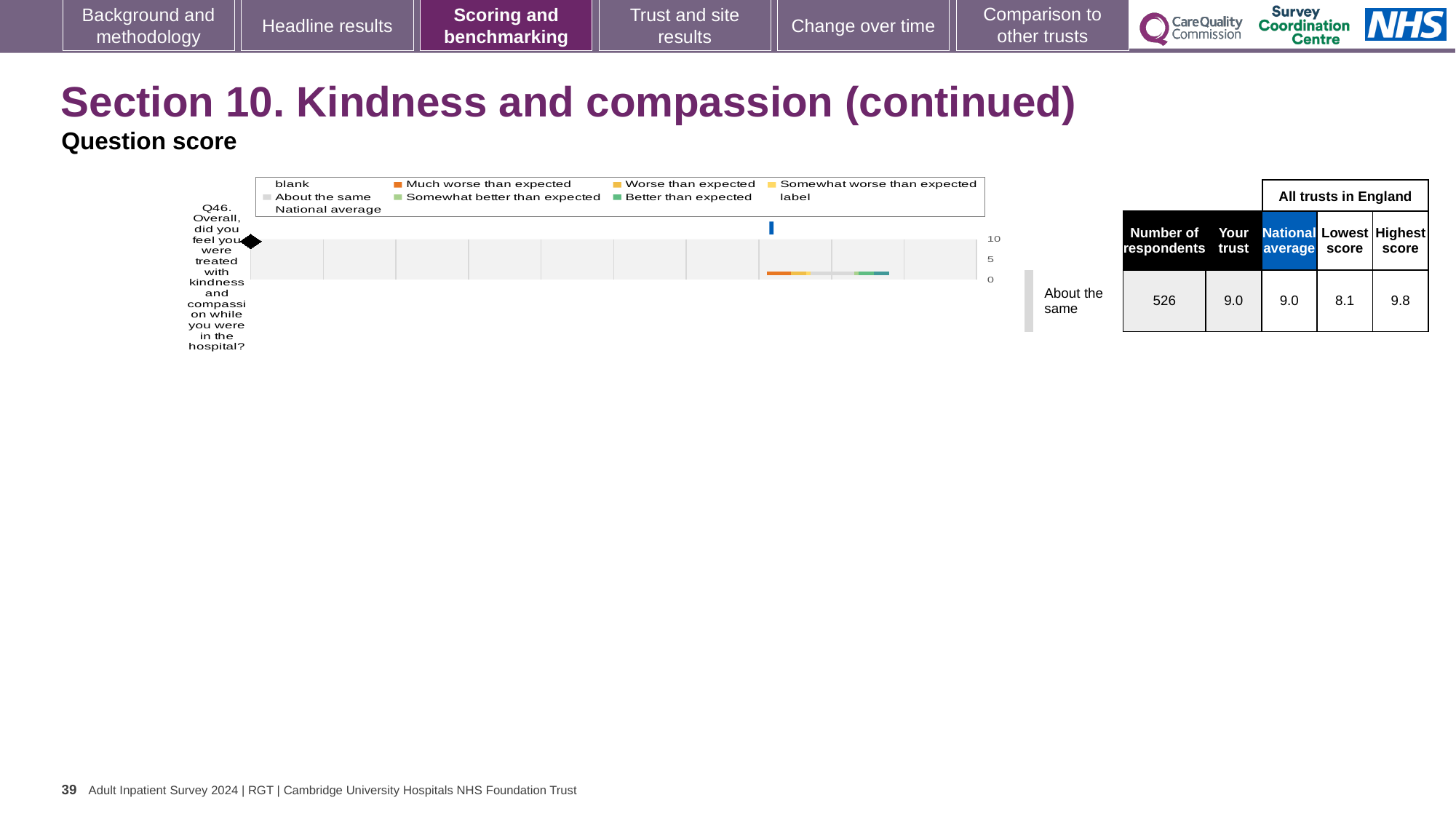
What kind of chart is shown on the slide for Q46? bar chart How many questions (categories) are plotted in the chart? 1 What is the difference between the highest score and the lowest score for Q46? 1.7 What is the 'Your trust' score for Q46 in the table beside the chart? 9.0 What is the highest score among all trusts in England for Q46? 9.8 What is the lowest score among all trusts in England for Q46? 8.1 How many entries does the chart legend list? 9 What colour does the legend use for 'Much worse than expected'? orange What is the national average score for Q46 in the table beside the chart? 9.0 How many respondents answered Q46? 526 Which rating category is shown for Q46 next to the chart? About the same Is the 'Your trust' score for Q46 higher than, lower than, or the same as the national average? the same